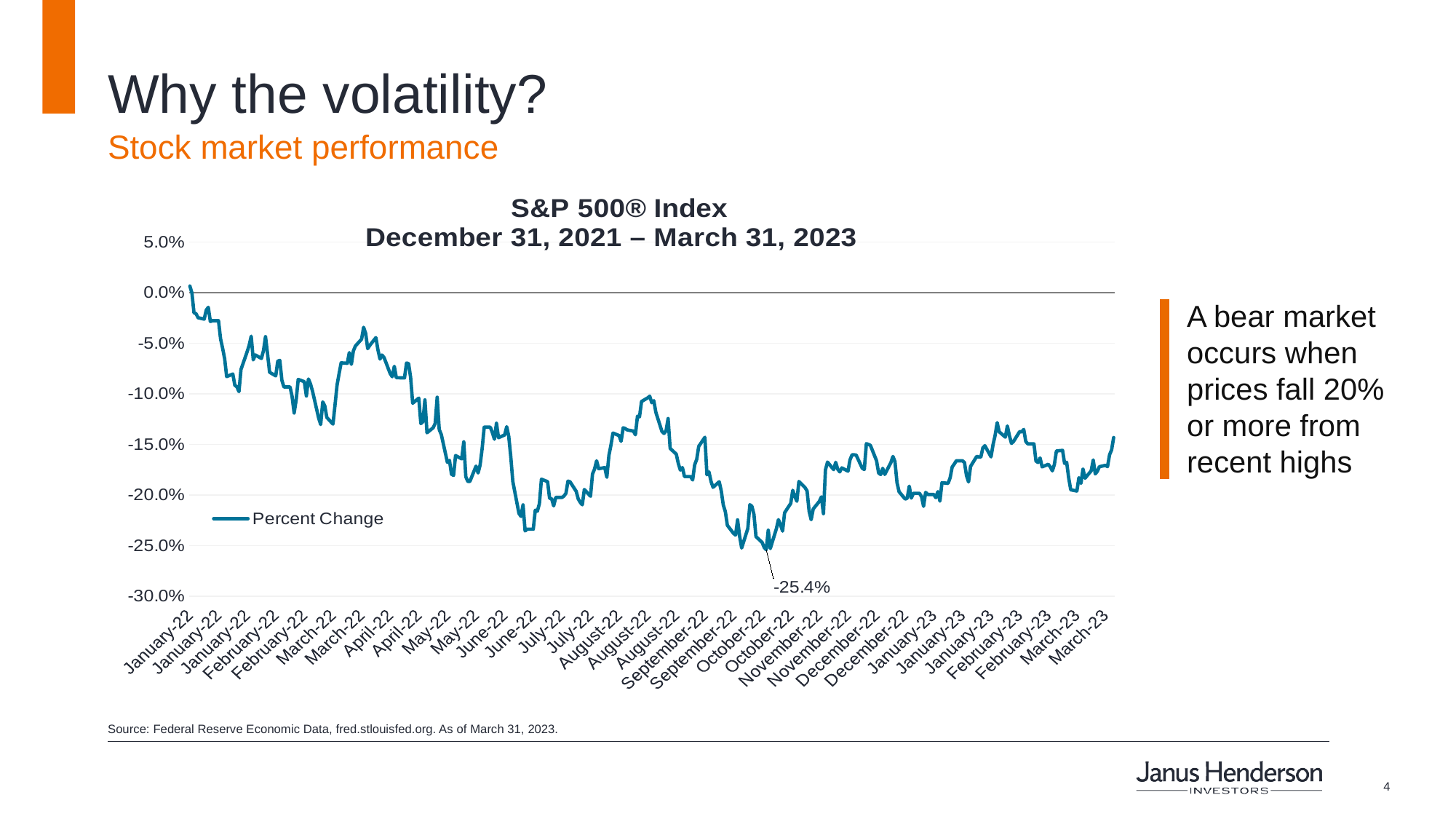
What is the name of the series shown in the legend? Percent Change Do the values generally rise or fall from January-22 to June-22? fall Is the lowest point in June-22 greater or less than -20.0%? less How many series does the legend list? 1 Is the value at the end of March-23 greater or less than -20.0%? greater What kind of chart is shown on the slide? line chart Do the values generally rise or fall from October-22 to March-23? rise In which month does the line reach its lowest point? October-22 Is the peak value in August-22 greater or less than -15.0%? greater What is the lowest value labeled on the chart? -25.4% What is the title of the chart? S&P 500® Index December 31, 2021 – March 31, 2023